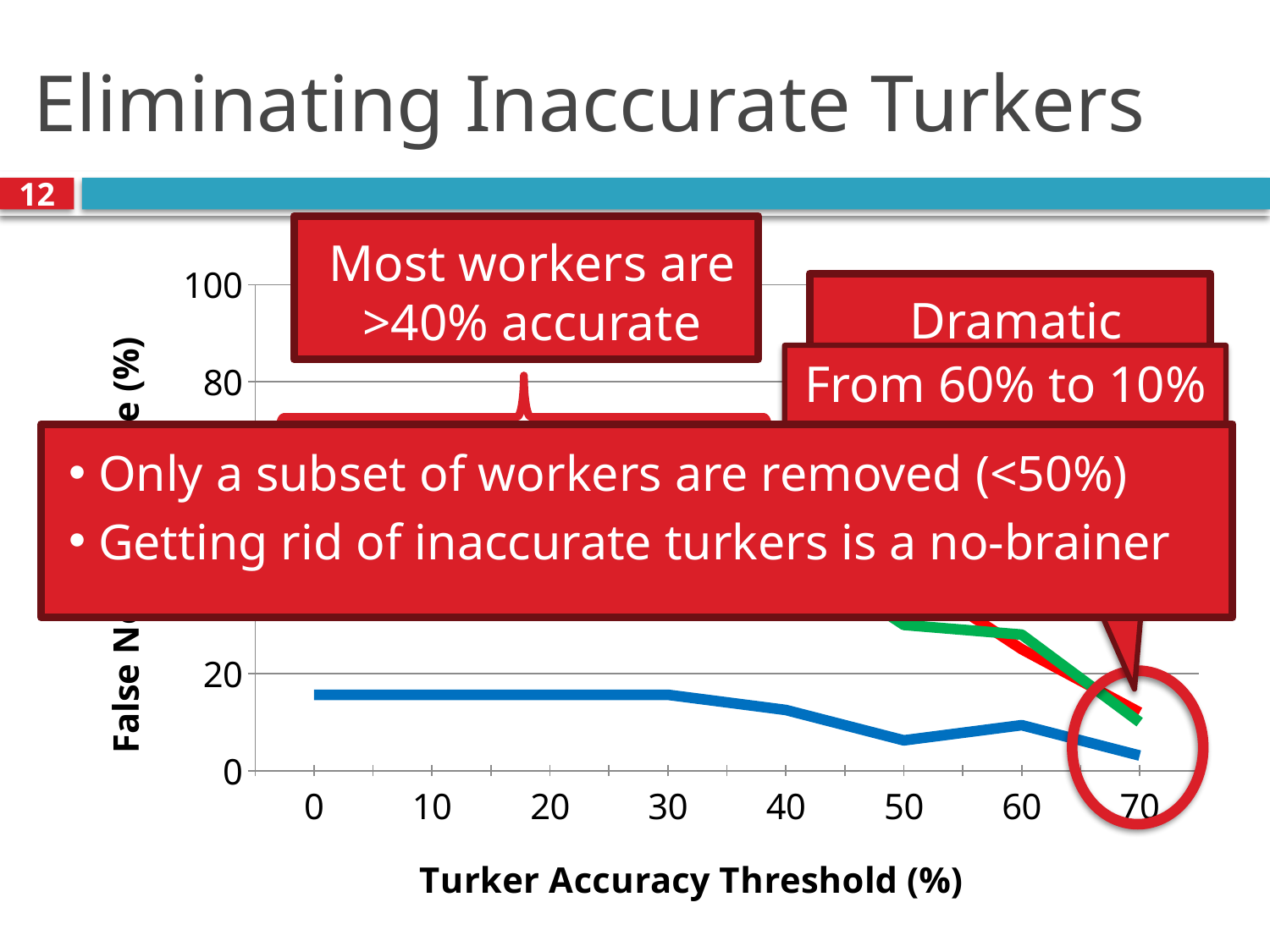
Is the value of the green line at a Turker Accuracy Threshold of 70 greater or less than 20? less What kind of chart is shown on the slide? line chart How many tick labels are shown along the x axis of the chart? 8 Is the value of the blue line at a Turker Accuracy Threshold of 0 greater or less than 20? less At a Turker Accuracy Threshold of 70, which line has the lower value, the blue line or the green line? blue line Is the value of the blue line at a Turker Accuracy Threshold of 70 greater or less than 20? less How many coloured lines are plotted on the chart? 3 What is the label of the x axis of the chart? Turker Accuracy Threshold (%) What is the highest value labelled on the y axis of the chart? 100 At a Turker Accuracy Threshold of 60, which line has the higher value, the green line or the blue line? green line Does the blue line rise or fall as the Turker Accuracy Threshold increases from 0 to 70? fall